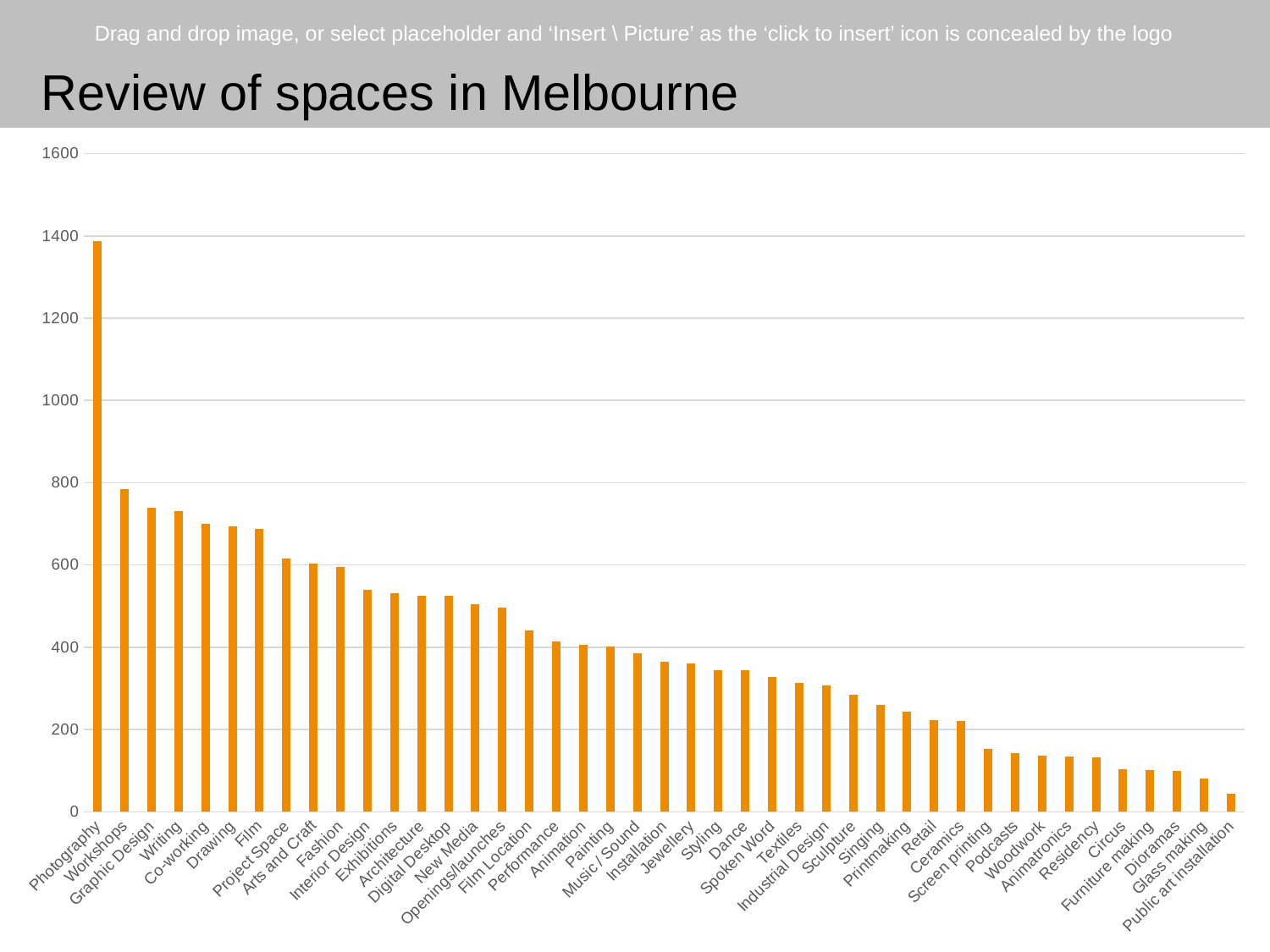
Is the value for Sculpture greater or less than 200? greater Is the value for Workshops greater or less than 600? greater Which category has the lowest value? Public art installation Do the values rise or fall moving from left to right along the x axis? fall What is the title of the slide containing the chart? Review of spaces in Melbourne Is the value for Film Location greater or less than 400? greater Which category has the highest value? Photography Which has a larger value, Writing or Painting? Writing What type of chart is shown on the slide? bar chart Which has a larger value, Circus or Dance? Dance